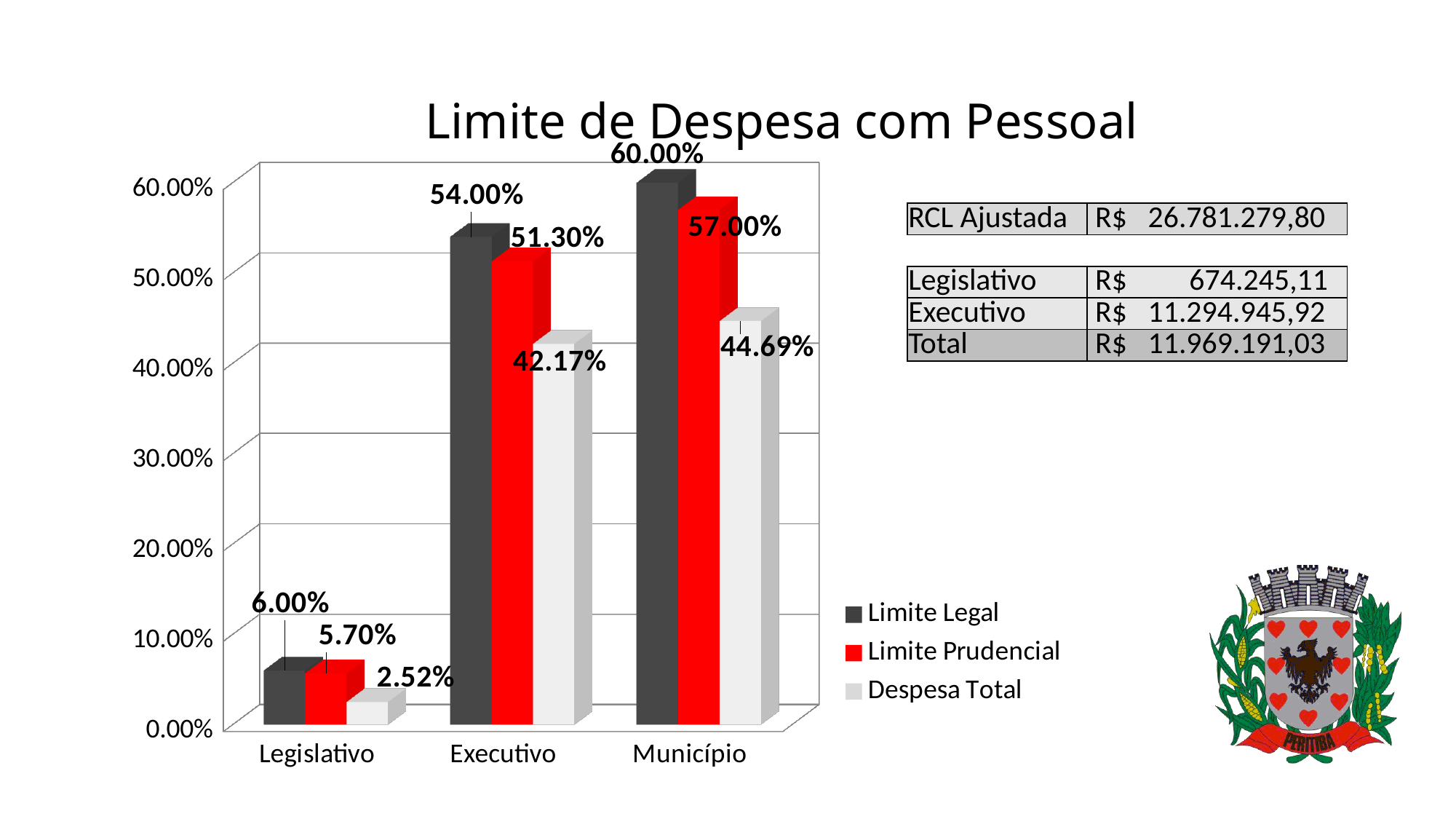
How many series does the legend list? 3 Which category has the highest Limite Legal value? Município Which category has the lowest Despesa Total value? Legislativo What is the Despesa Total value for Legislativo? 2.52% What is the Limite Legal value for Legislativo? 6.00% What is the Limite Prudencial value for Município? 57.00% What is the Despesa Total value for Executivo? 42.17% What is the title of the chart? Limite de Despesa com Pessoal What is the difference between the Limite Legal and the Despesa Total for Executivo? 11.83% How many categories are shown on the x axis? 3 Which is larger for Município: Limite Prudencial or Despesa Total? Limite Prudencial What kind of chart is shown? Bar chart